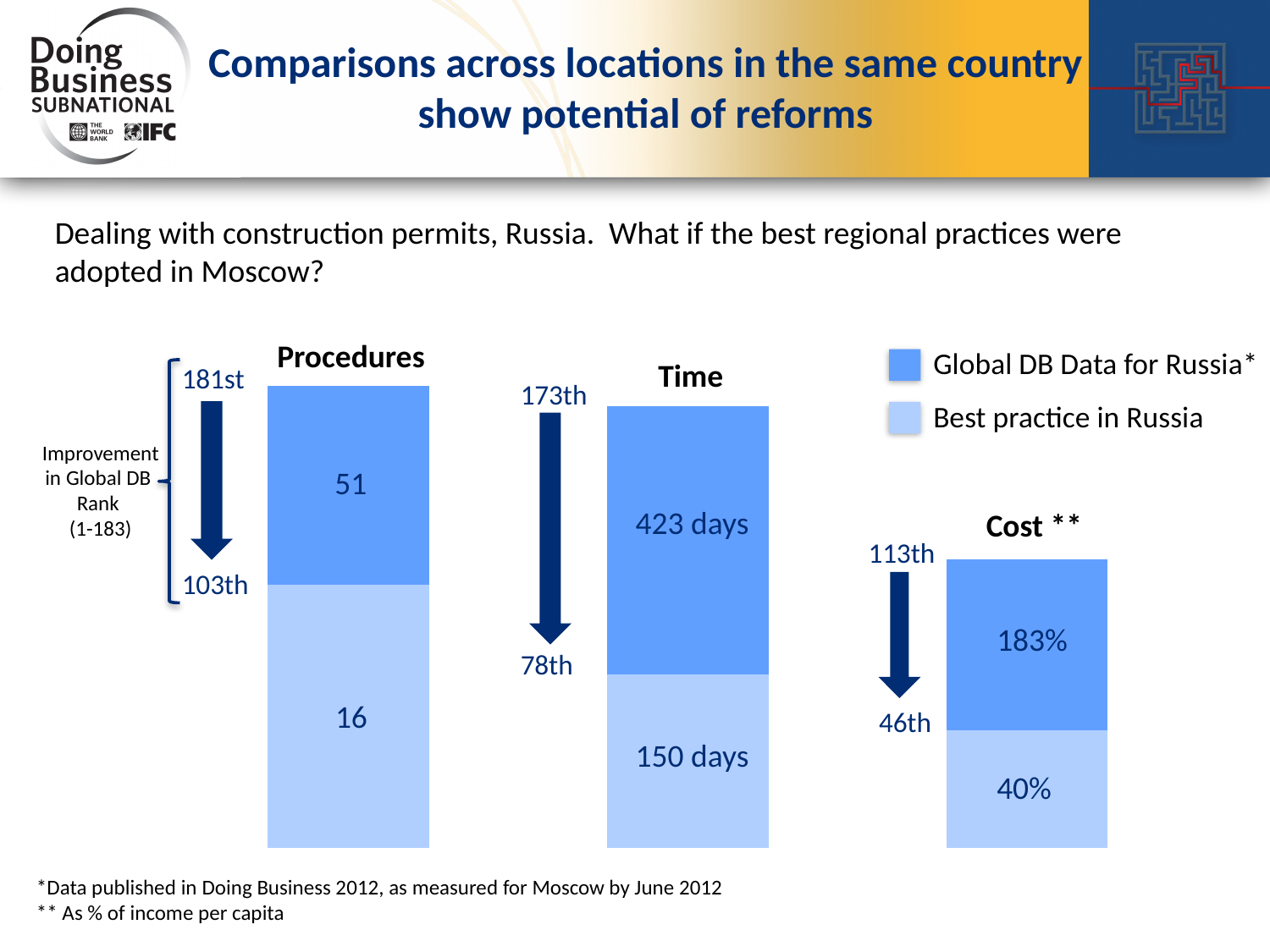
How many series does the legend list? 2 In the Time chart, how many days are shown for Global DB Data for Russia? 423 days In the Time chart, how many days are shown for Best practice in Russia? 150 days In the Procedures chart, what is the difference between the Global DB Data for Russia value and the Best practice in Russia value? 35 Which legend entry is shown in the lighter blue colour? Best practice in Russia In the Cost chart, what is the value for Best practice in Russia? 40% In the Procedures chart, what is the value for Best practice in Russia? 16 In the Time chart, what is the difference in days between Global DB Data for Russia and Best practice in Russia? 273 days In the Procedures chart, what is the value for Global DB Data for Russia? 51 What kind of chart is used for Procedures, Time and Cost? Stacked bar chart In the Cost chart, what is the value for Global DB Data for Russia? 183% In the Cost chart, which is larger: Global DB Data for Russia or Best practice in Russia? Global DB Data for Russia